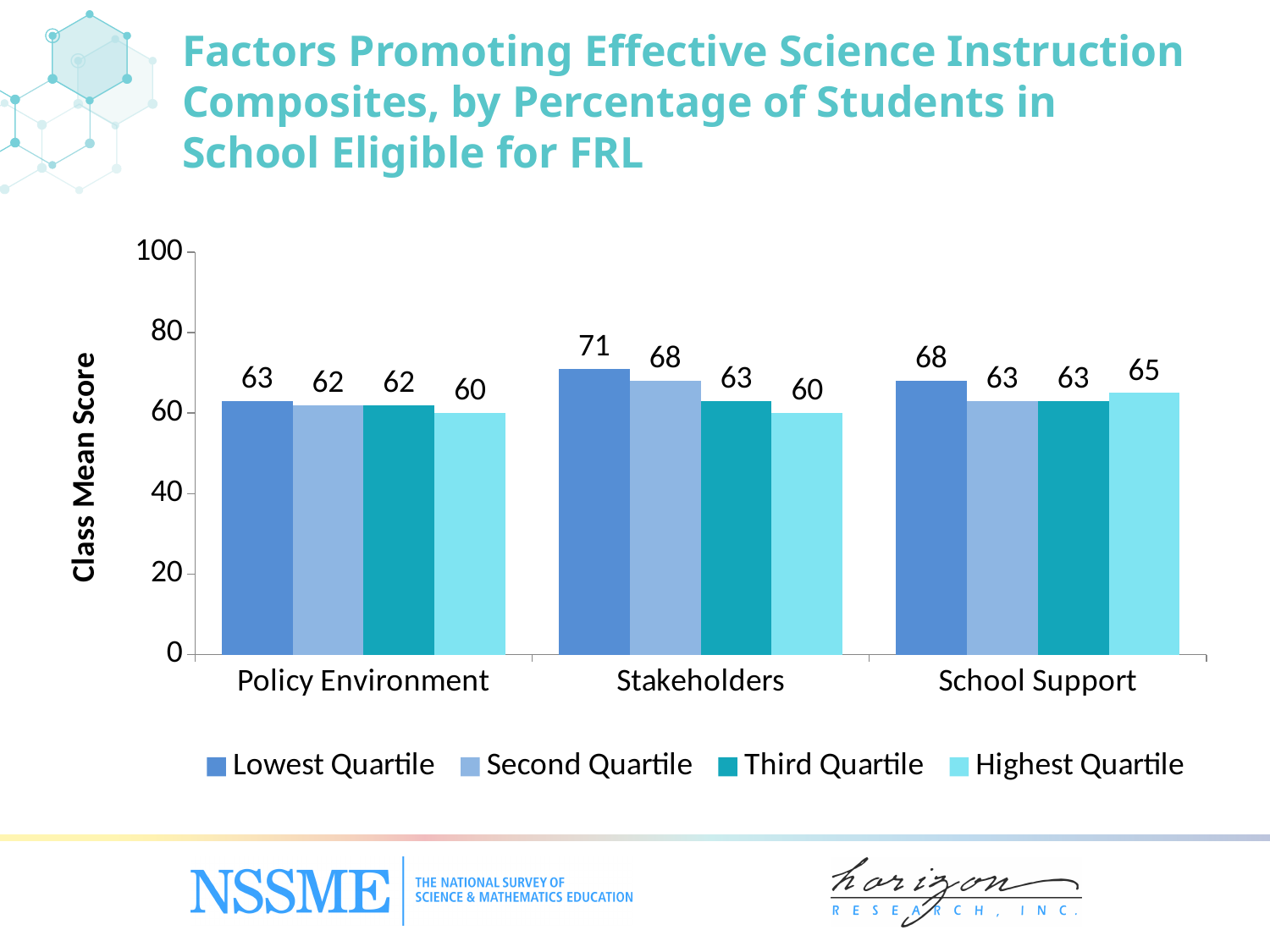
What is the class mean score for the Highest Quartile on the School Support composite? 65 Which is larger: the Lowest Quartile score for Stakeholders or the Lowest Quartile score for School Support? Stakeholders What is the class mean score for the Lowest Quartile on the Stakeholders composite? 71 How many series does the legend list? 4 What is the class mean score for the Second Quartile on the Policy Environment composite? 62 What kind of chart is shown on the slide? Bar chart What is the label of the y axis? Class Mean Score How many composites are shown on the x axis? 3 Which quartile has the highest class mean score on the Stakeholders composite? Lowest Quartile Which quartile has the lowest class mean score on the Policy Environment composite? Highest Quartile Is the Lowest Quartile score for Stakeholders greater or less than 80? less What is the difference between the Lowest Quartile and Highest Quartile scores on the Stakeholders composite? 11